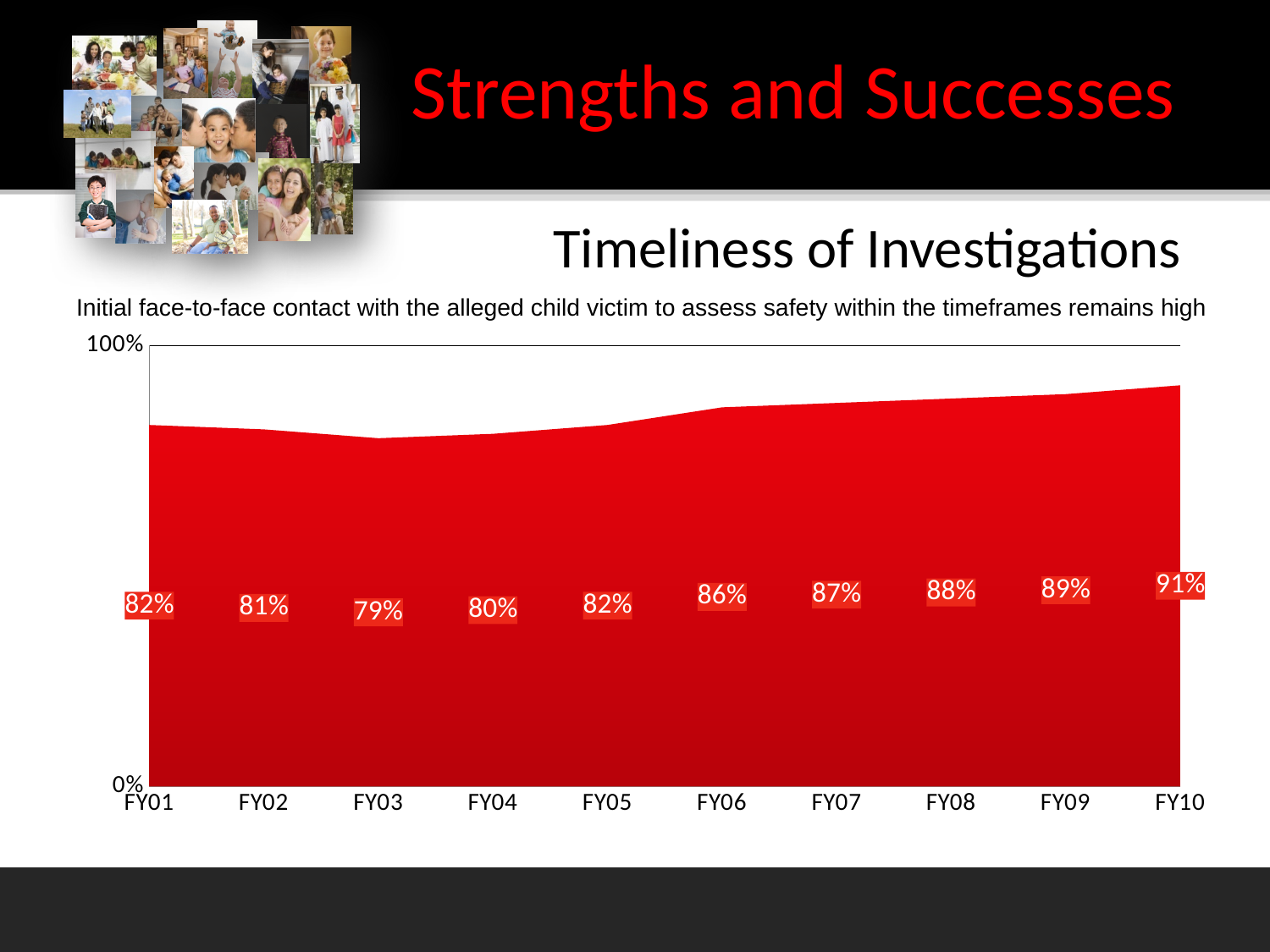
Which fiscal year has the highest value? FY10 What is the difference between the values for FY07 and FY03? 8% What is the value for FY06? 86% What is the value for FY01? 82% What kind of chart is shown? area chart Which is larger, the value for FY02 or the value for FY08? FY08 What is the title of the chart? Timeliness of Investigations How many fiscal years are plotted on the chart? 10 Do the values generally rise or fall from FY03 to FY10? rise What is the value for FY10? 91% Which fiscal year has the lowest value? FY03 What is the difference between the values for FY10 and FY01? 9%